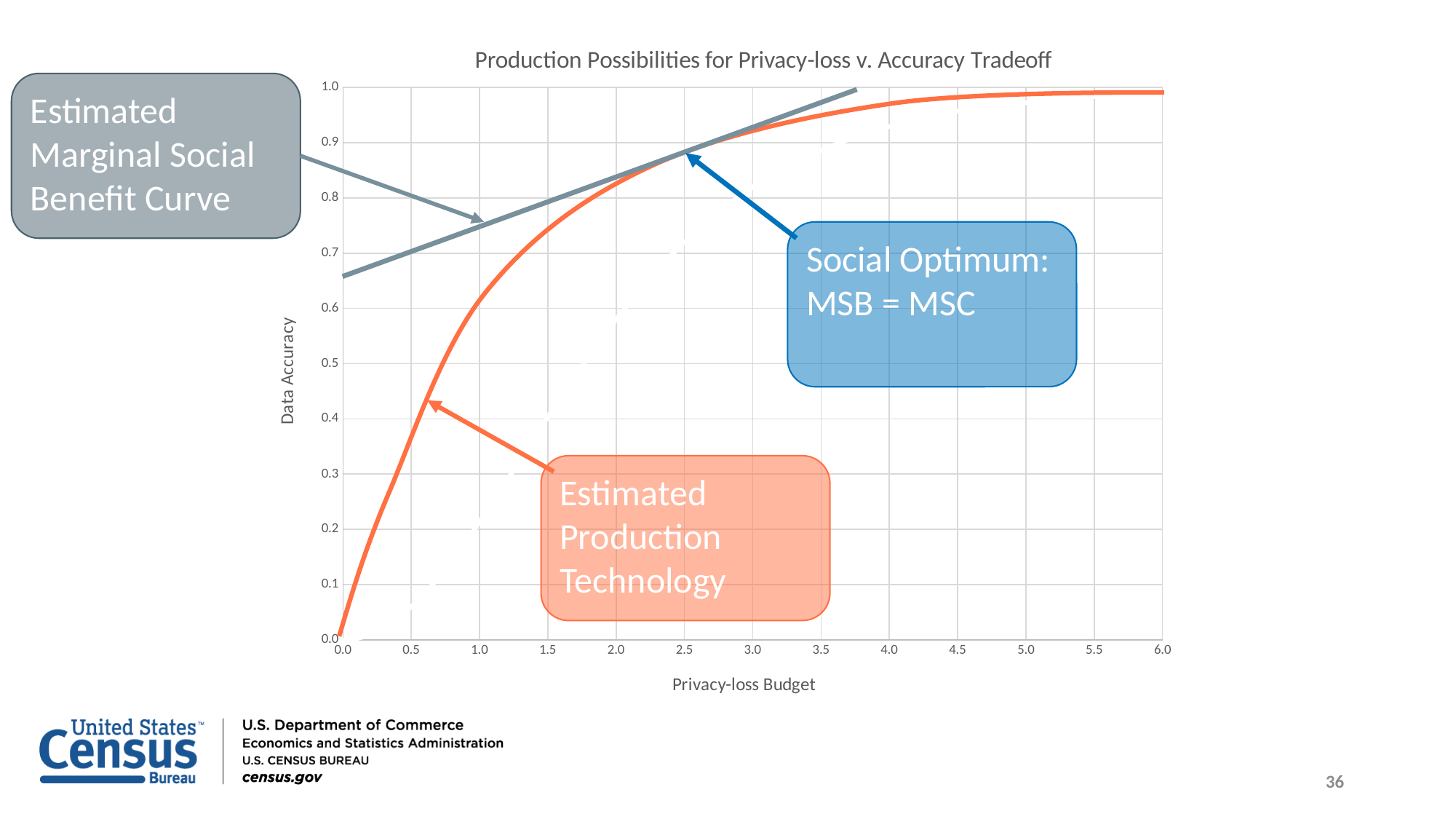
What kind of chart is shown on the slide? line chart At a Privacy-loss Budget of 0.5, which curve has the higher Data Accuracy, the Estimated Marginal Social Benefit Curve or the Estimated Production Technology curve? Estimated Marginal Social Benefit Curve What is the title of the chart? Production Possibilities for Privacy-loss v. Accuracy Tradeoff What is the Data Accuracy of the Estimated Production Technology curve at a Privacy-loss Budget of 0.0? 0.0 Is the Data Accuracy of the Estimated Production Technology curve at a Privacy-loss Budget of 5.0 greater or less than 0.9? greater Is the Data Accuracy of the Estimated Marginal Social Benefit Curve at a Privacy-loss Budget of 0.0 greater or less than 0.6? greater Is the Data Accuracy of the Estimated Production Technology curve at a Privacy-loss Budget of 0.5 greater or less than 0.5? less Does the Estimated Marginal Social Benefit Curve rise or fall as the Privacy-loss Budget increases? rise Does the Estimated Production Technology curve rise or fall as the Privacy-loss Budget increases? rise How many curves are plotted on the chart? 2 What is the label of the x axis? Privacy-loss Budget